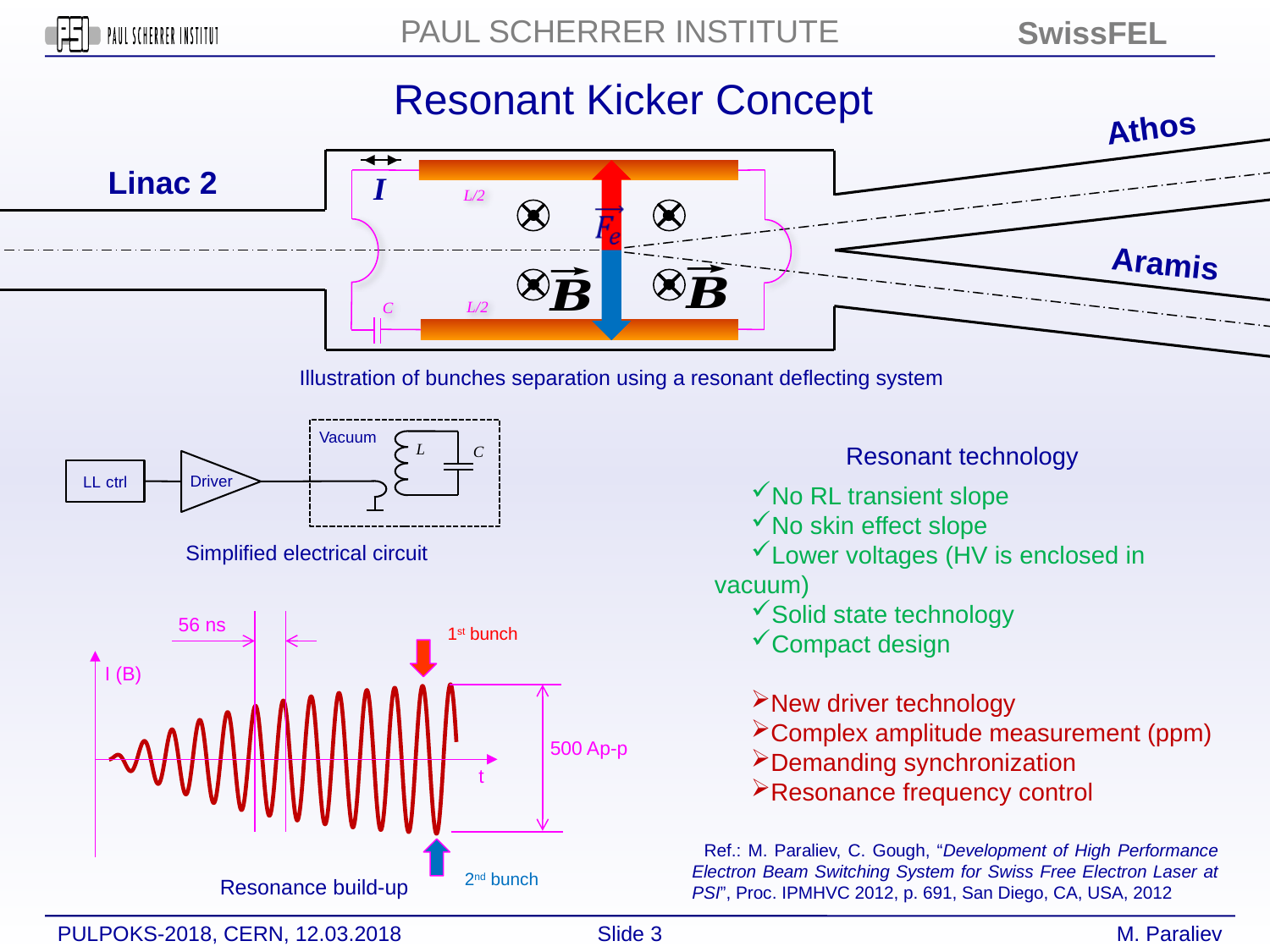
In the Resonance build-up plot, which bunch arrow is shown at the top of the waveform, the 1st bunch or the 2nd bunch? 1st bunch In the Resonance build-up plot, what is the label on the horizontal axis? t In the Resonance build-up plot, what peak-to-peak amplitude is labeled on the waveform? 500 Ap-p In the Resonance build-up plot, what is the label on the vertical axis? I (B) In the Resonance build-up plot, which bunch arrow is shown at the bottom of the waveform? 2nd bunch In the Resonance build-up plot, what time interval is marked between the two vertical lines? 56 ns In the Resonance build-up plot, does the oscillation amplitude increase or decrease along the t axis? increase